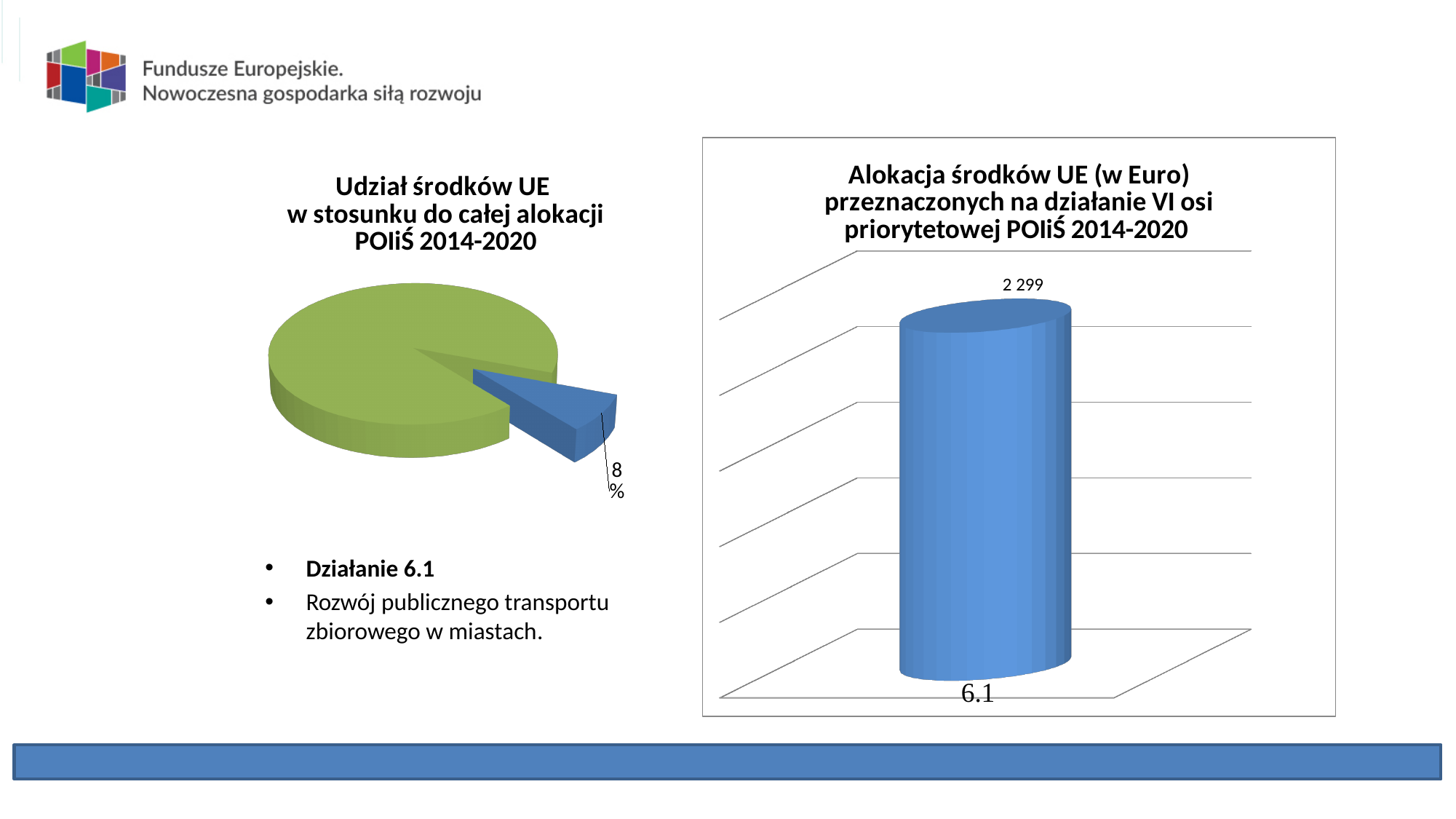
What is the category label under the bar in the chart on the right? 6.1 How many bars does the chart on the right of the slide show? 1 What is the title of the pie chart on the left of the slide? Udział środków UE w stosunku do całej alokacji POIiŚ 2014-2020 What kind of chart is the chart on the left of the slide? pie chart In the pie chart on the left, what share does the blue slice represent? 8% In the pie chart on the left, what colour is the slice labelled 8%? blue What kind of chart is the chart on the right of the slide? bar chart How many slices does the pie chart on the left have? 2 In the pie chart on the left, which slice is larger, the green one or the blue one? the green one In the chart titled 'Alokacja środków UE (w Euro) przeznaczonych na działanie VI osi priorytetowej POIiŚ 2014-2020', what value is shown for category 6.1? 2 299